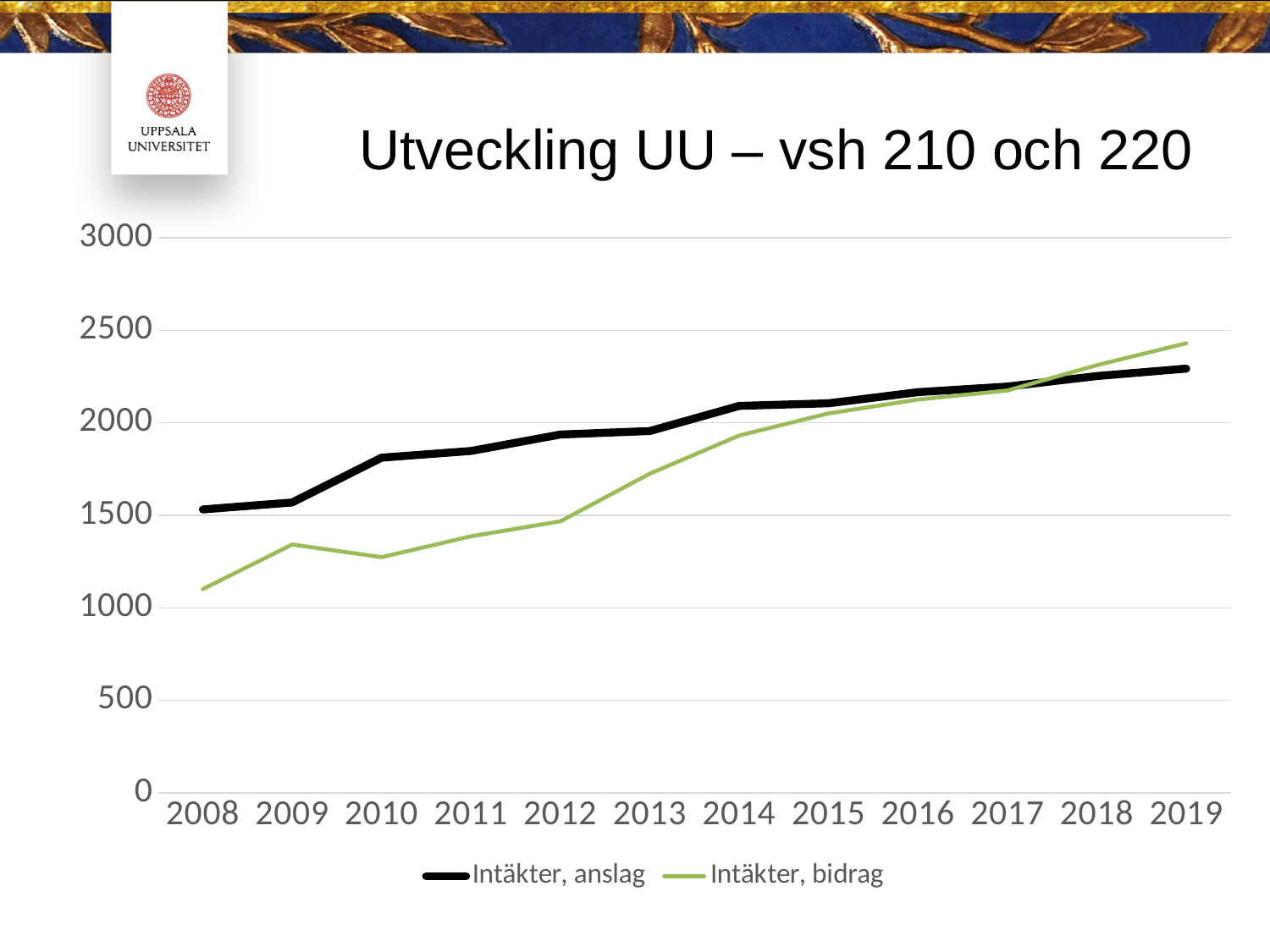
Which series is drawn with the thick black line? Intäkter, anslag Is the value for Intäkter, bidrag in 2008 greater or less than 1000? greater What kind of chart is shown on the slide? line chart What is the title of the chart? Utveckling UU – vsh 210 och 220 In 2019, which series has the larger value, Intäkter, anslag or Intäkter, bidrag? Intäkter, bidrag Is the value for Intäkter, anslag in 2014 greater or less than 2000? greater Is the value for Intäkter, bidrag in 2019 greater or less than 2500? less In 2008, which series has the larger value, Intäkter, anslag or Intäkter, bidrag? Intäkter, anslag How many series does the legend list? 2 Does the Intäkter, bidrag series generally rise or fall from 2008 to 2019? rise How many years are shown on the x axis? 12